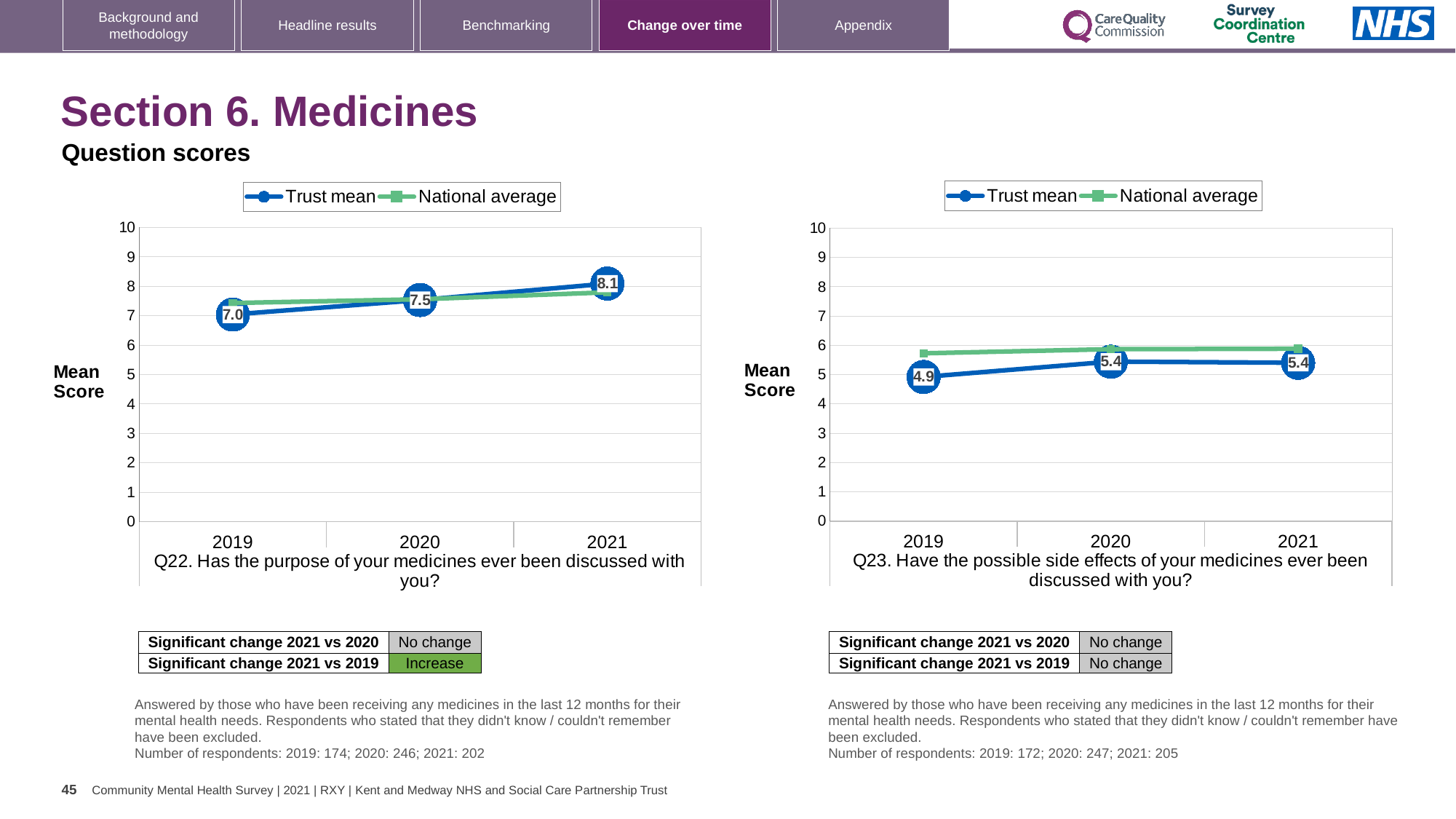
On the Q22 chart (left), what is the Trust mean score for 2021? 8.1 On the Q23 chart (right), is the National average for 2019 greater or less than 5? greater On the Q23 chart (right), what is the difference between the Trust mean in 2020 and in 2019? 0.5 What kind of chart is the Q23 chart (right)? line chart On the Q23 chart (right), in which year is the Trust mean lowest? 2019 On the Q22 chart (left), in which year is the Trust mean highest? 2021 How many series does the legend of the Q22 chart (left) list? 2 On the Q22 chart (left), what is the Trust mean score for 2019? 7.0 On the Q22 chart (left), what is the difference between the Trust mean in 2021 and in 2019? 1.1 On the Q22 chart (left), does the Trust mean rise or fall from 2019 to 2021? rise On the Q23 chart (right), what is the Trust mean score for 2019? 4.9 On the Q23 chart (right), what is the Trust mean score for 2020? 5.4